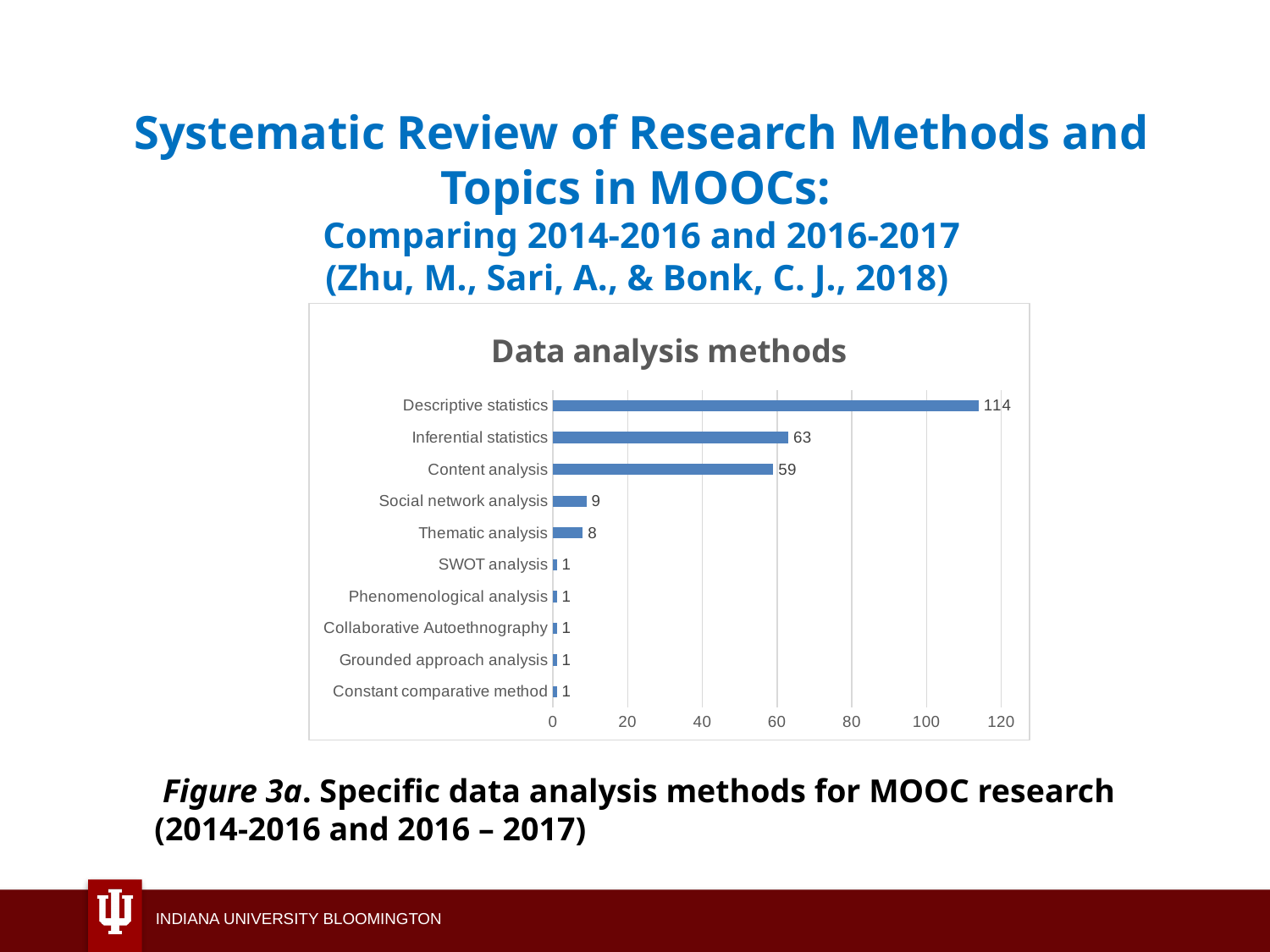
What is the value for Descriptive statistics? 114 What is the value for Social network analysis? 9 Which data analysis method has the highest value? Descriptive statistics What is the title of the chart? Data analysis methods What is the difference between the values for Descriptive statistics and Inferential statistics? 51 What is the difference between the values for Inferential statistics and Content analysis? 4 What is the value for Content analysis? 59 Is the value for Inferential statistics greater or less than 60? greater How many data analysis methods have a value of 1? 5 What kind of chart is shown on the slide? Bar chart How many data analysis methods are shown in the chart? 10 Which is larger, the value for Social network analysis or the value for Thematic analysis? Social network analysis